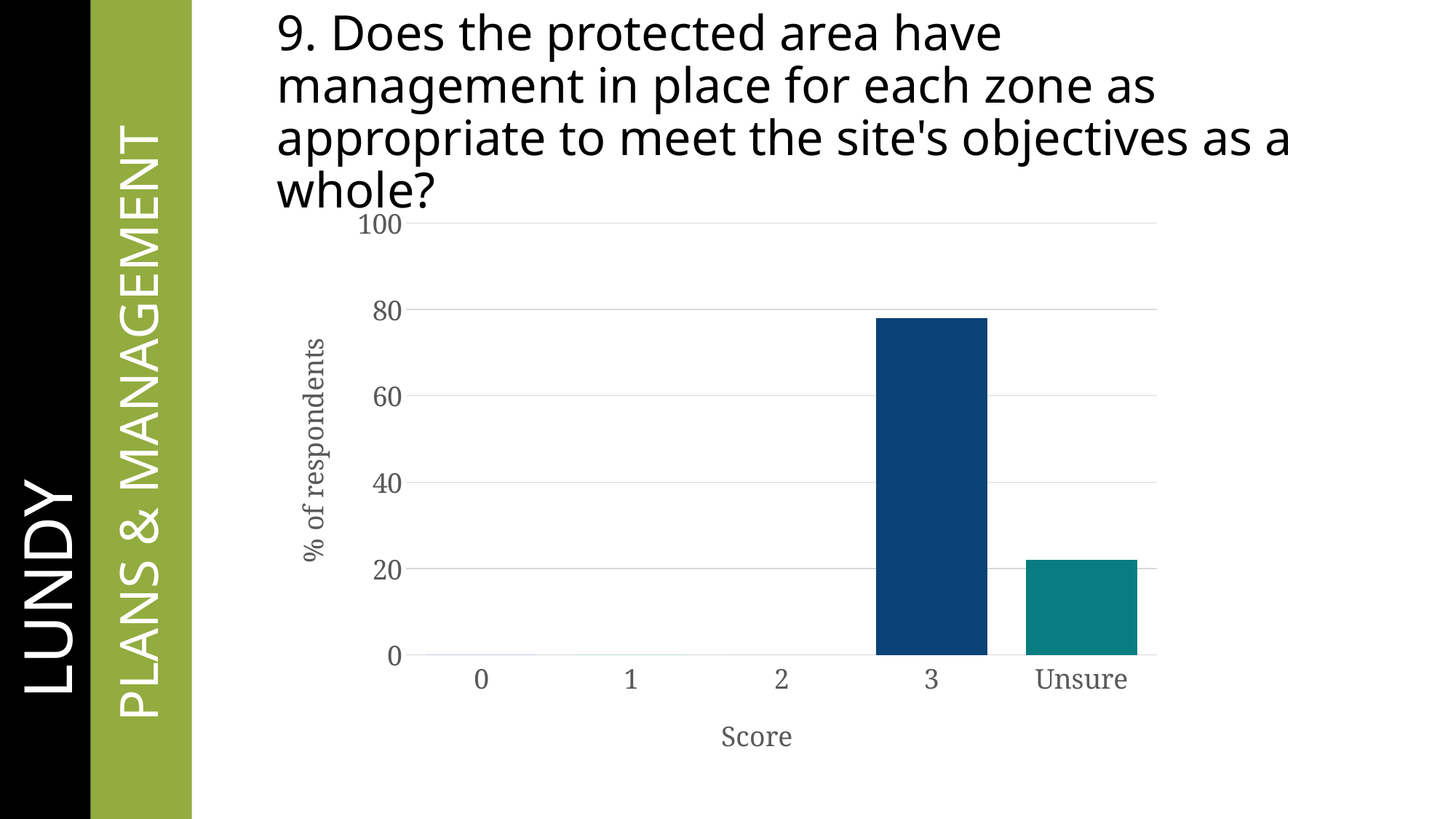
Is the value for score 3 greater or less than 60? greater What is the label of the vertical axis of the chart? % of respondents Is the value for score 3 greater or less than 80? less Which score categories have no visible bar in the chart? 0, 1 and 2 How many categories are shown on the x axis of the chart? 5 Is the value for Unsure greater or less than 40? less What kind of chart is shown on the slide? bar chart Which is larger, the value for score 3 or the value for Unsure? 3 What is the maximum value shown on the vertical axis? 100 Which score category has the highest percentage of respondents? 3